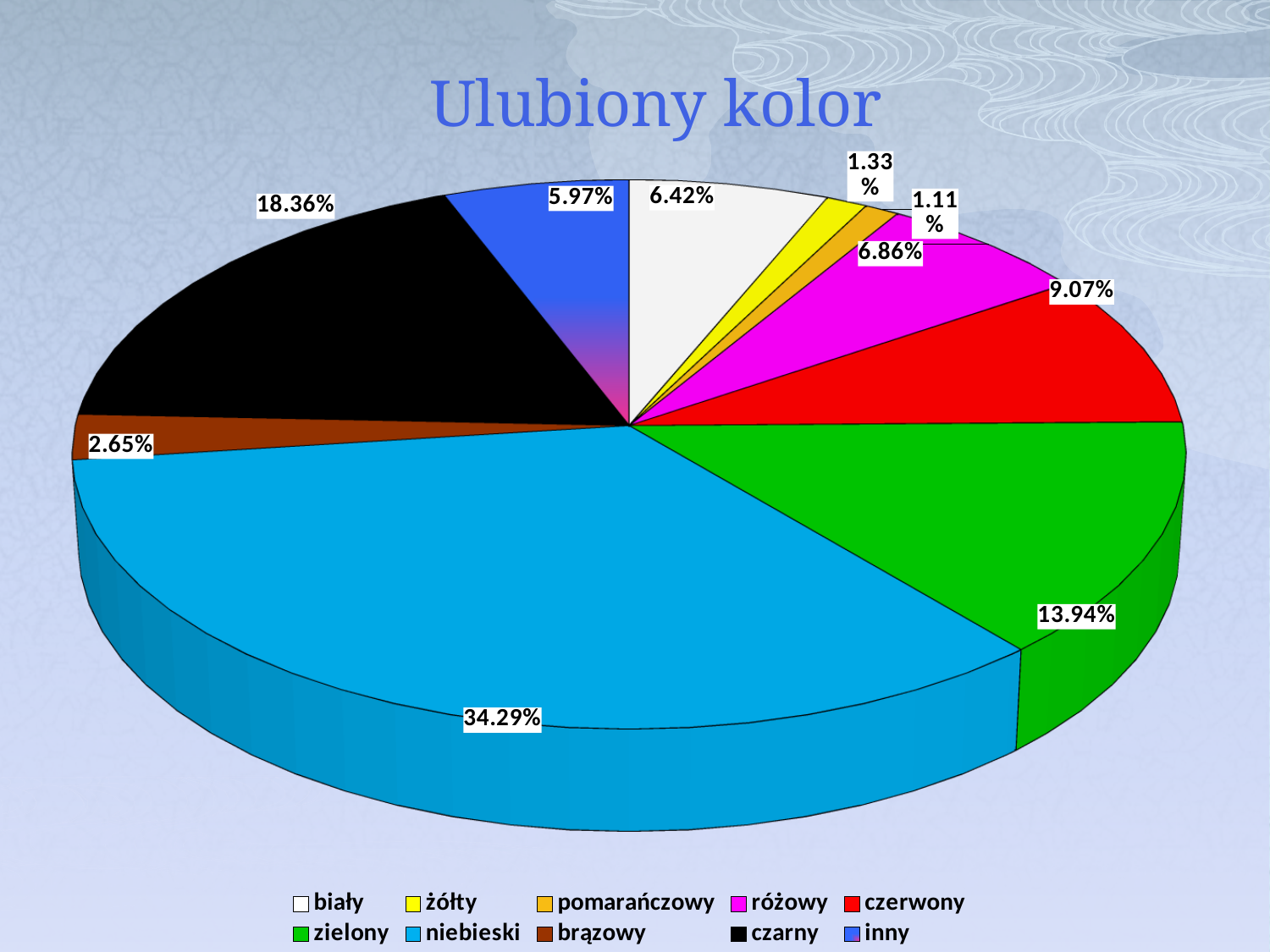
What is the value for zielony? 13.94% How many categories does the legend list? 10 What is the value for pomarańczowy? 1.11% What is the value for brązowy? 2.65% Which category has the largest slice? niebieski Which is larger, the share for czerwony or the share for różowy? czerwony What share of the pie does niebieski have? 34.29% Which category has the smallest slice? pomarańczowy What is the title of the chart? Ulubiony kolor What is the difference between the shares of niebieski and czarny? 15.93% What kind of chart is shown on the slide? pie chart What share of the pie does czarny have? 18.36%